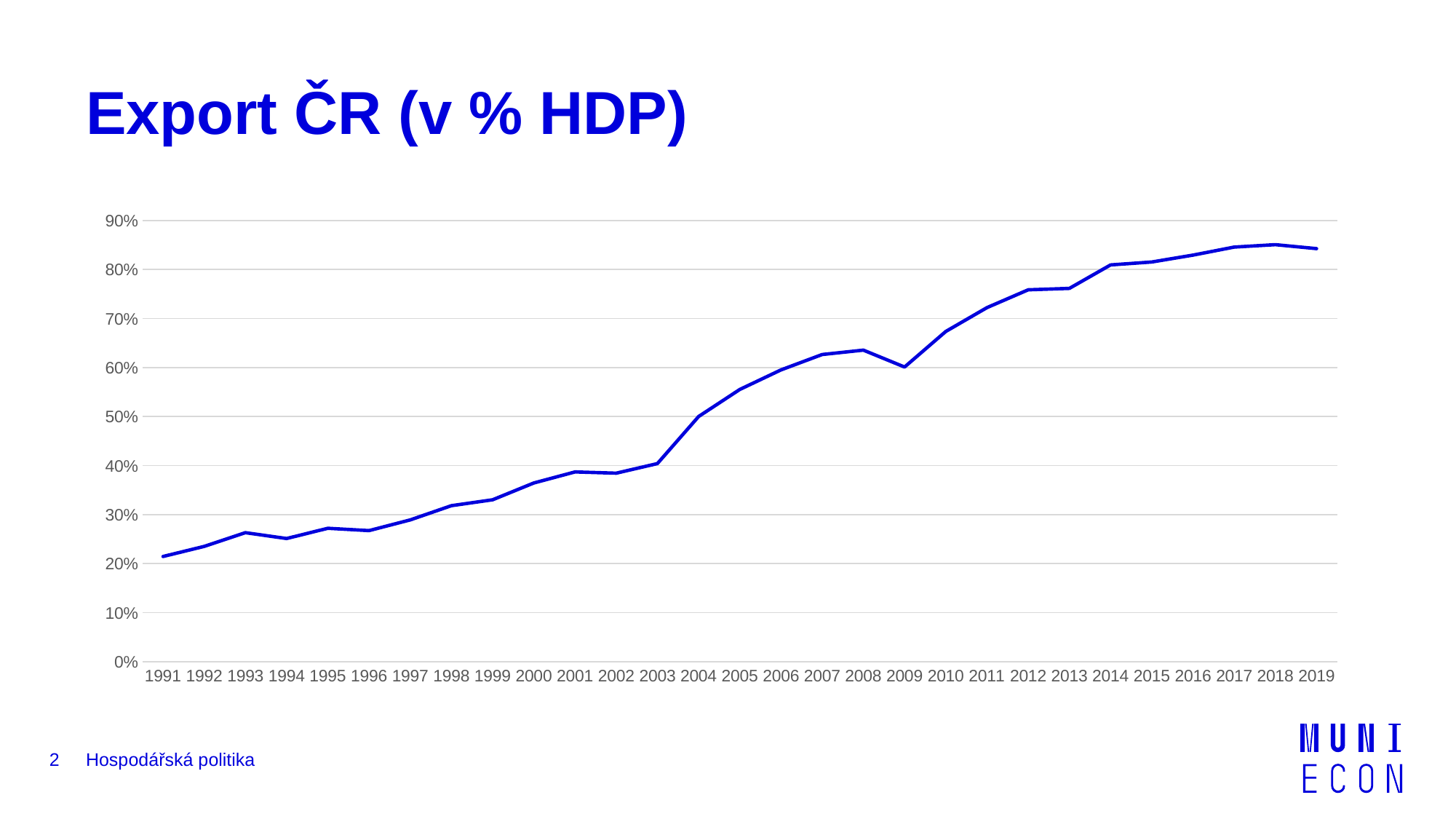
Is the value for 2007 greater or less than 60%? greater Is the value for 2012 greater or less than 70%? greater How many years are plotted on the x axis? 29 Is the value for 2016 greater or less than 80%? greater Which year has the lowest export value? 1991 What is the title of the chart? Export ČR (v % HDP) Which year has the larger value, 2008 or 2009? 2008 Do the values generally rise or fall from 1991 to 2019? rise What kind of chart is shown on the slide? line chart What colour is the plotted line? blue